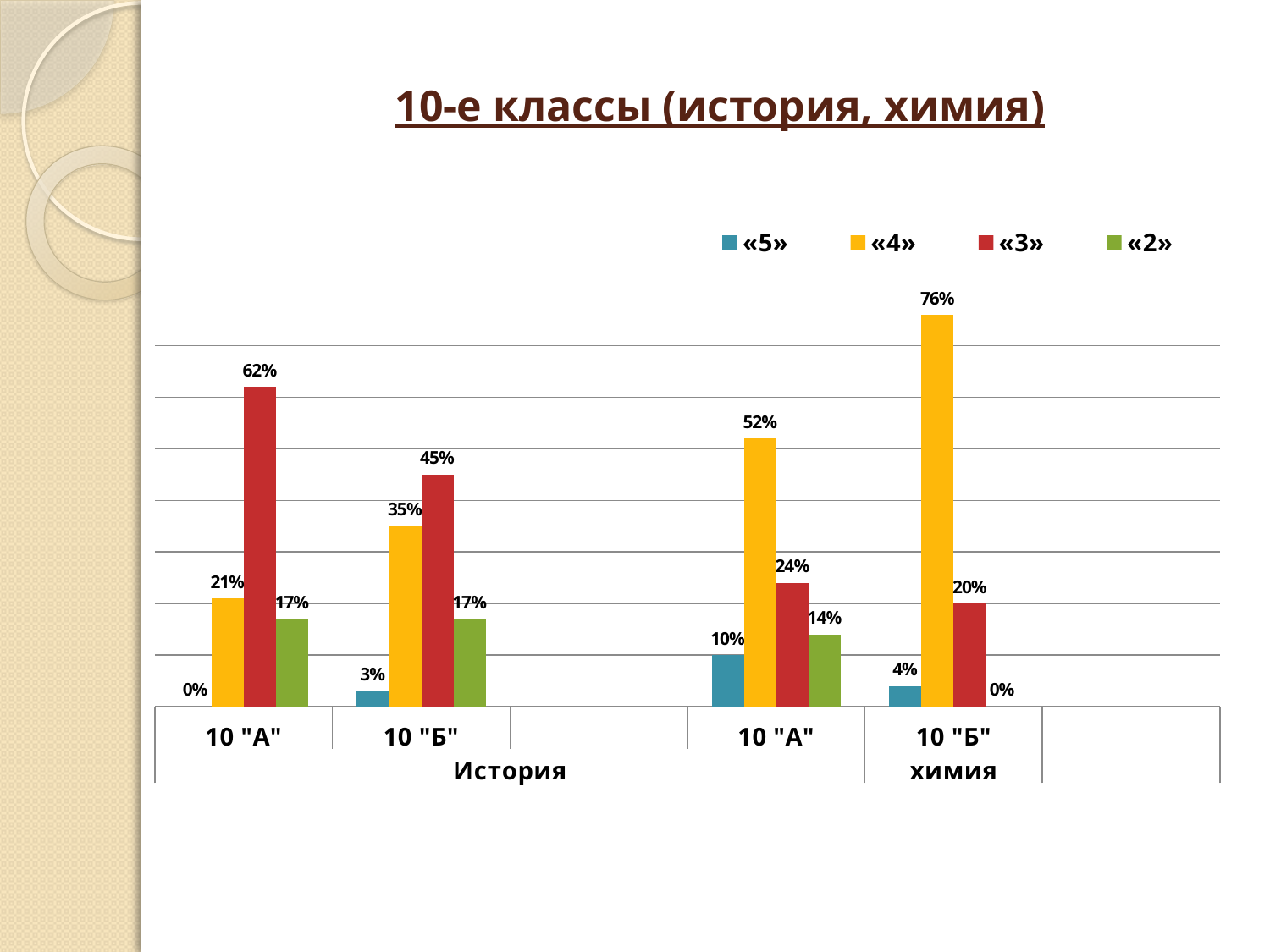
What is the difference between the «3» values for 10 "А" and 10 "Б" in История? 17% What is the value of «4» for 10 "Б" in химия? 76% How many class groups are shown on the x axis? 4 Which is larger: «4» for 10 "А" in химия or «4» for 10 "Б" in История? «4» for 10 "А" in химия What is the value of «5» for 10 "А" in химия? 10% What kind of chart is shown on the slide? Bar chart What is the value of «3» for 10 "А" in История? 62% Which group has the lowest «3» value? 10 "Б" (химия) What colour represents the «4» series? Yellow How many series does the legend list? 4 What is the value of «2» for 10 "Б" in История? 17% Which group has the highest «4» value? 10 "Б" (химия)